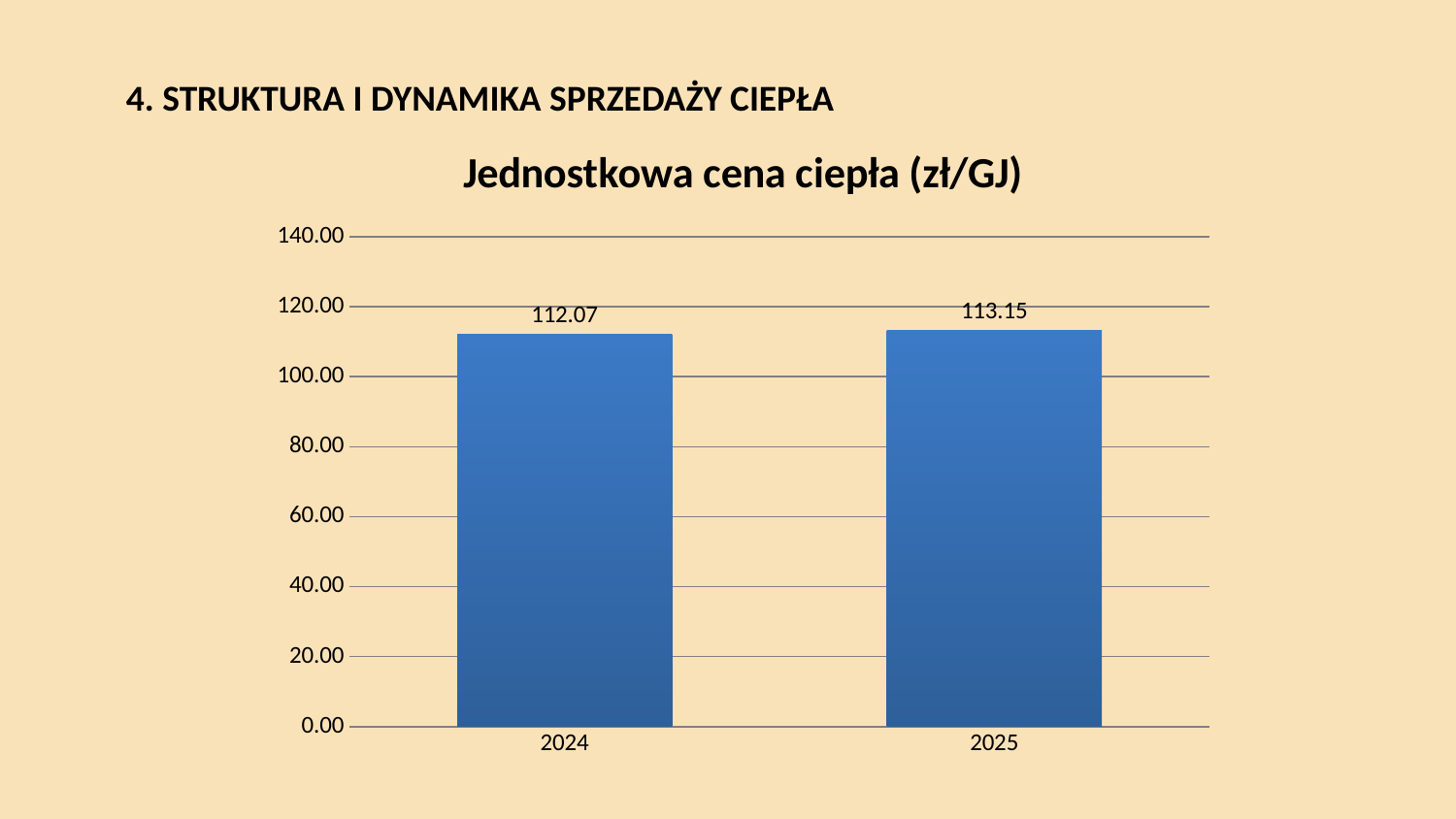
What is the title of the chart? Jednostkowa cena ciepła (zł/GJ) Which year has the lower unit heat price? 2024 Do the values rise or fall from 2024 to 2025? rise What is the value for 2024? 112.07 What is the value for 2025? 113.15 Which year has the higher unit heat price? 2025 What is the difference between the values for 2025 and 2024? 1.08 Is the value for 2024 greater or less than 100.00? greater How many categories are shown on the x axis? 2 Is the value for 2025 larger or smaller than the value for 2024? larger Is the value for 2025 greater or less than 120.00? less What kind of chart is shown on the slide? bar chart